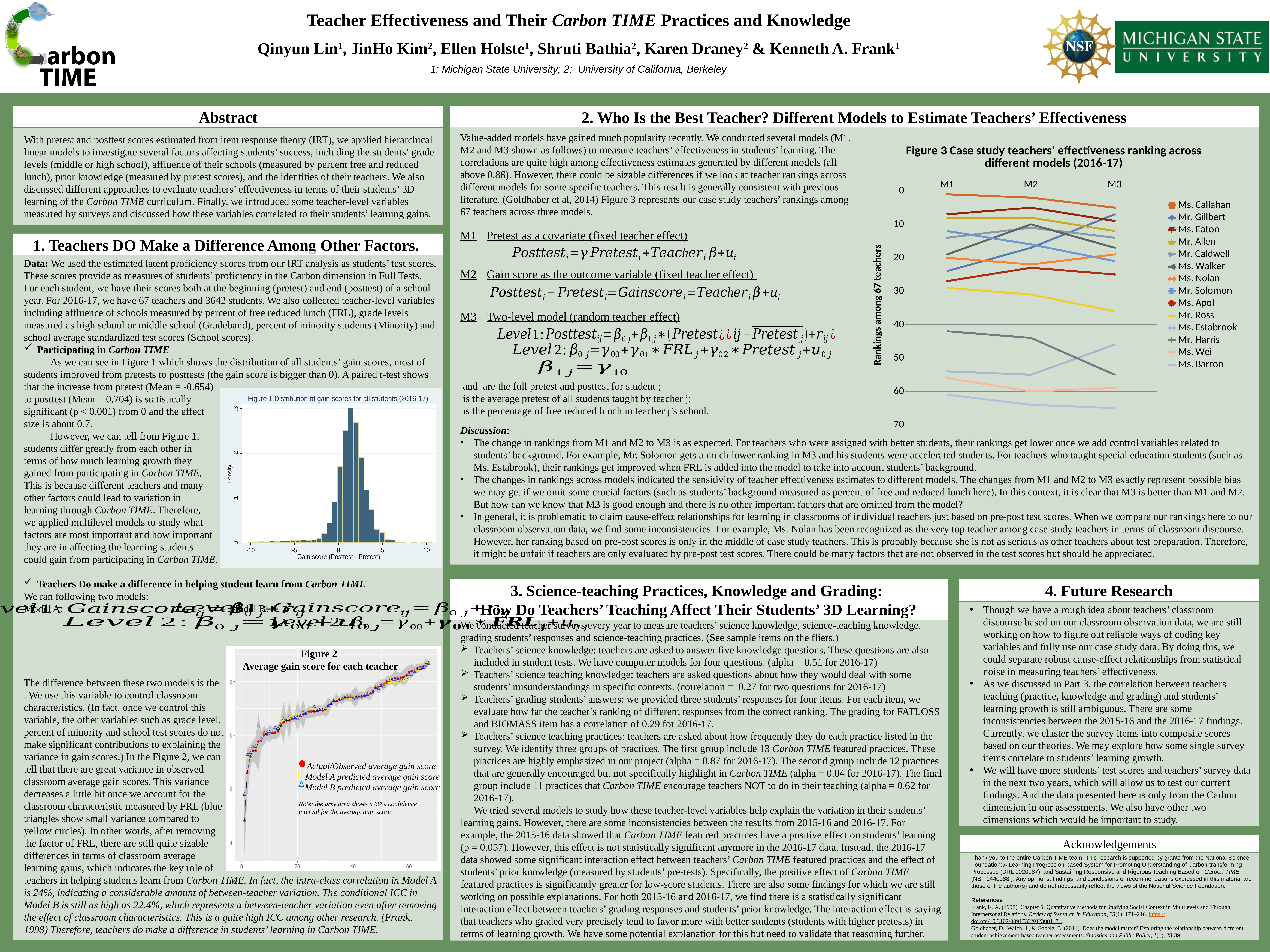
In Figure 3, how many teachers does the legend list? 14 In Figure 3, is the ranking for Ms. Barton under M3 greater or less than 60? greater In Figure 3, which teacher has the top (lowest-numbered) ranking under M1? Ms. Callahan In Figure 1, is the density of the tallest bar greater or less than 0.2? greater What kind of chart is Figure 1 (Distribution of gain scores for all students)? bar chart In Figure 3, what is the label of the y axis? Rankings among 67 teachers In Figure 3, how many models are shown along the x axis? 3 In Figure 2 (Average gain score for each teacher), how many series does the legend list? 3 In Figure 3, is the ranking for Ms. Callahan under M1 greater or less than 10? less What kind of chart is Figure 3 (Case study teachers' effectiveness ranking across different models)? line chart In Figure 1, what is the label of the x axis? Gain score (Posttest - Pretest)